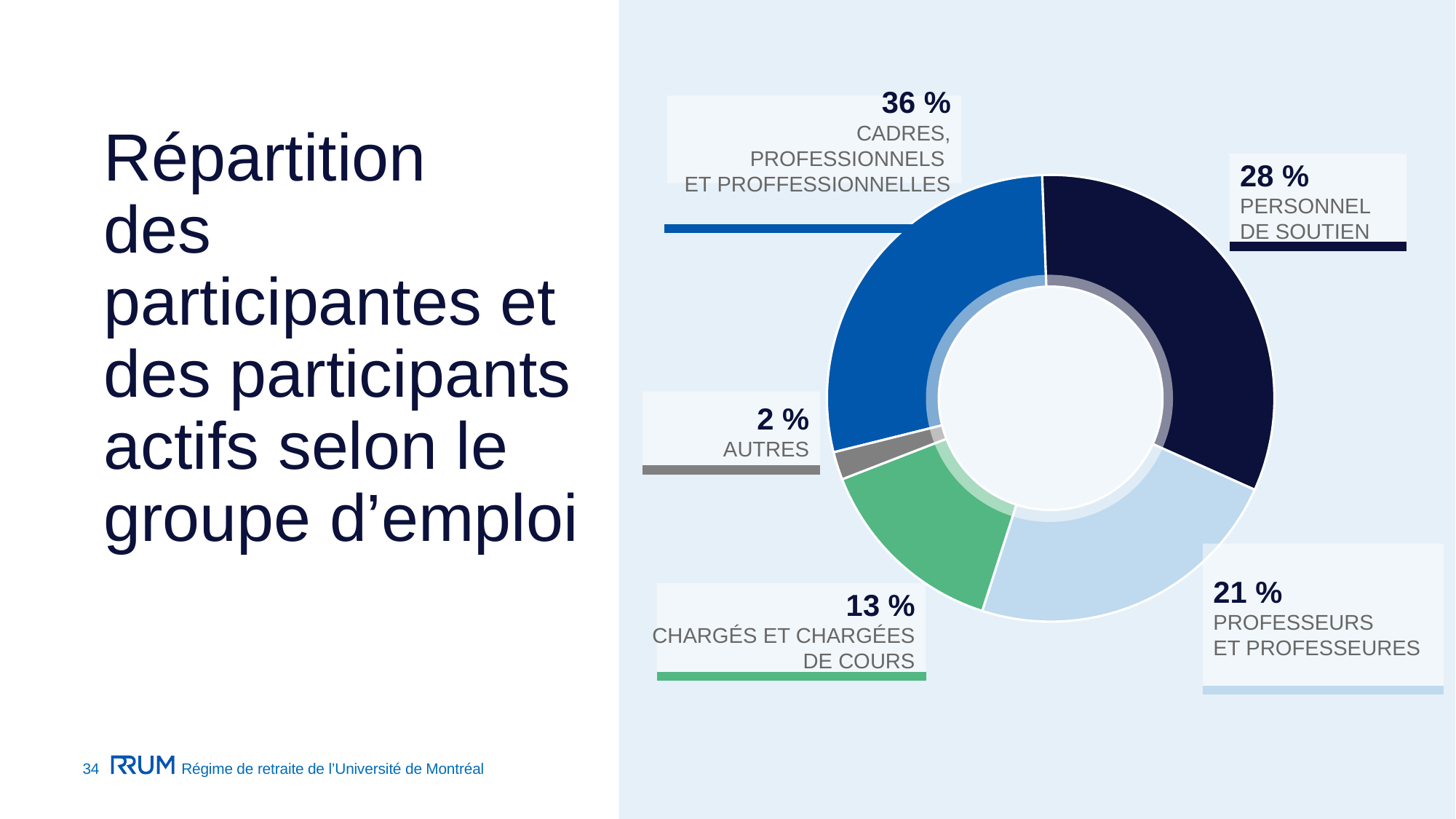
What kind of chart is used on this slide? Pie chart (doughnut) Which employment group has the smallest share of active participants? Autres What share of active participants are 'Chargés et chargées de cours'? 13 % What is the difference in percentage points between 'Personnel de soutien' and 'Professeurs et professeures'? 7 Which employment group has the largest share of active participants? Cadres, professionnels et professionnelles What colour is the slice for 'Chargés et chargées de cours'? Green What share of active participants are 'Cadres, professionnels et professionnelles'? 36 % What is the combined share of 'Cadres, professionnels et professionnelles' and 'Personnel de soutien'? 64 % What share of active participants are in the 'Personnel de soutien' group? 28 % Which group has a larger share: 'Chargés et chargées de cours' or 'Professeurs et professeures'? Professeurs et professeures What share of active participants are in the 'Autres' group? 2 % How many employment groups are shown in the chart? 5